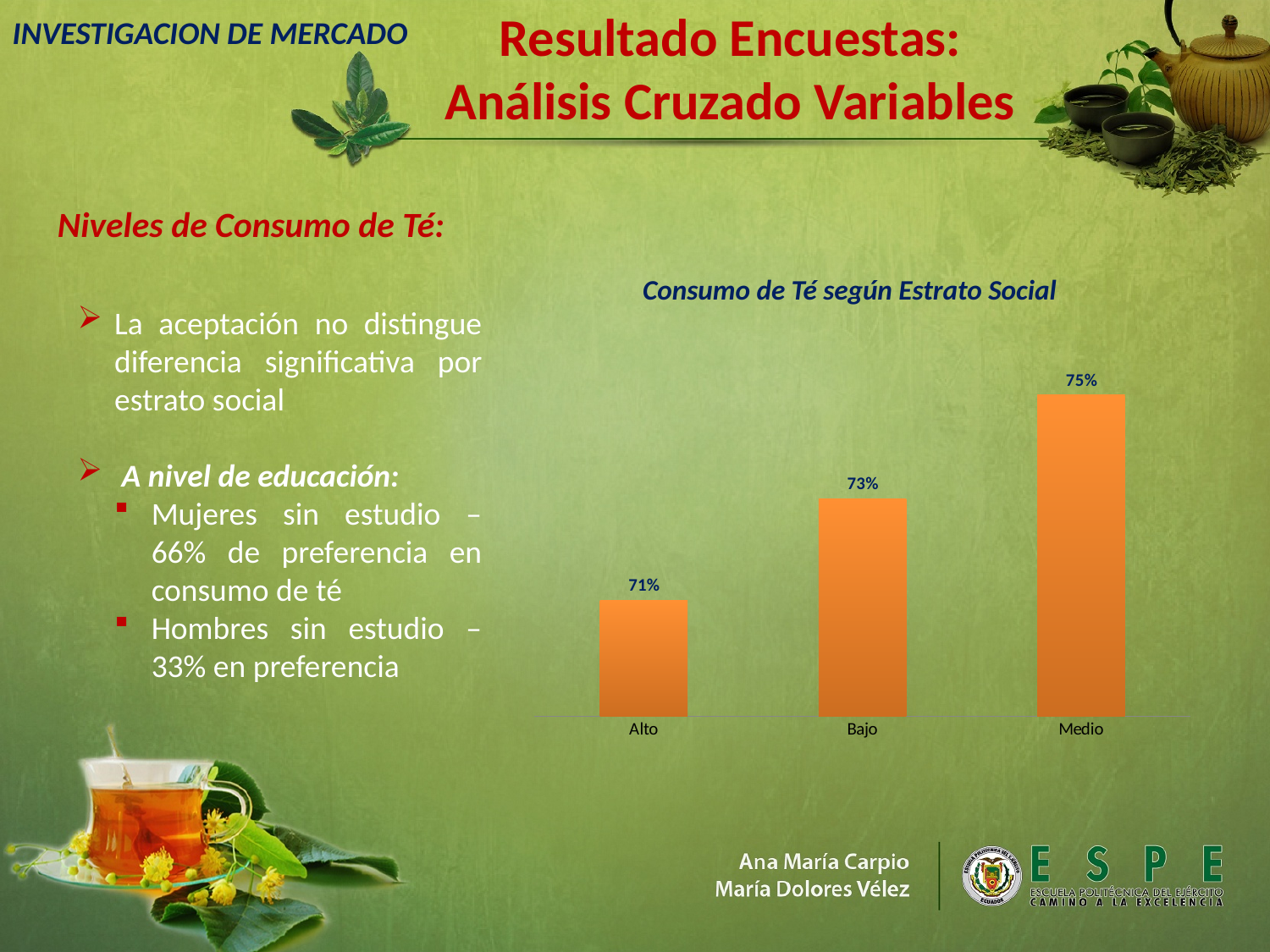
Which category has the lowest value in the chart? Alto What is the title of the chart? Consumo de Té según Estrato Social What is the difference between the values for Bajo and Alto? 2% What is the difference between the values for Medio and Alto? 4% What is the value for Bajo in the chart? 73% Which category has the highest value in the chart? Medio What is the value for Medio in the chart? 75% What is the value for Alto in the chart? 71% What kind of chart is shown on the slide? Bar chart Which is larger, the value for Bajo or the value for Medio? Medio How many categories are shown in the chart? 3 Do the values rise or fall from left to right across the categories? Rise